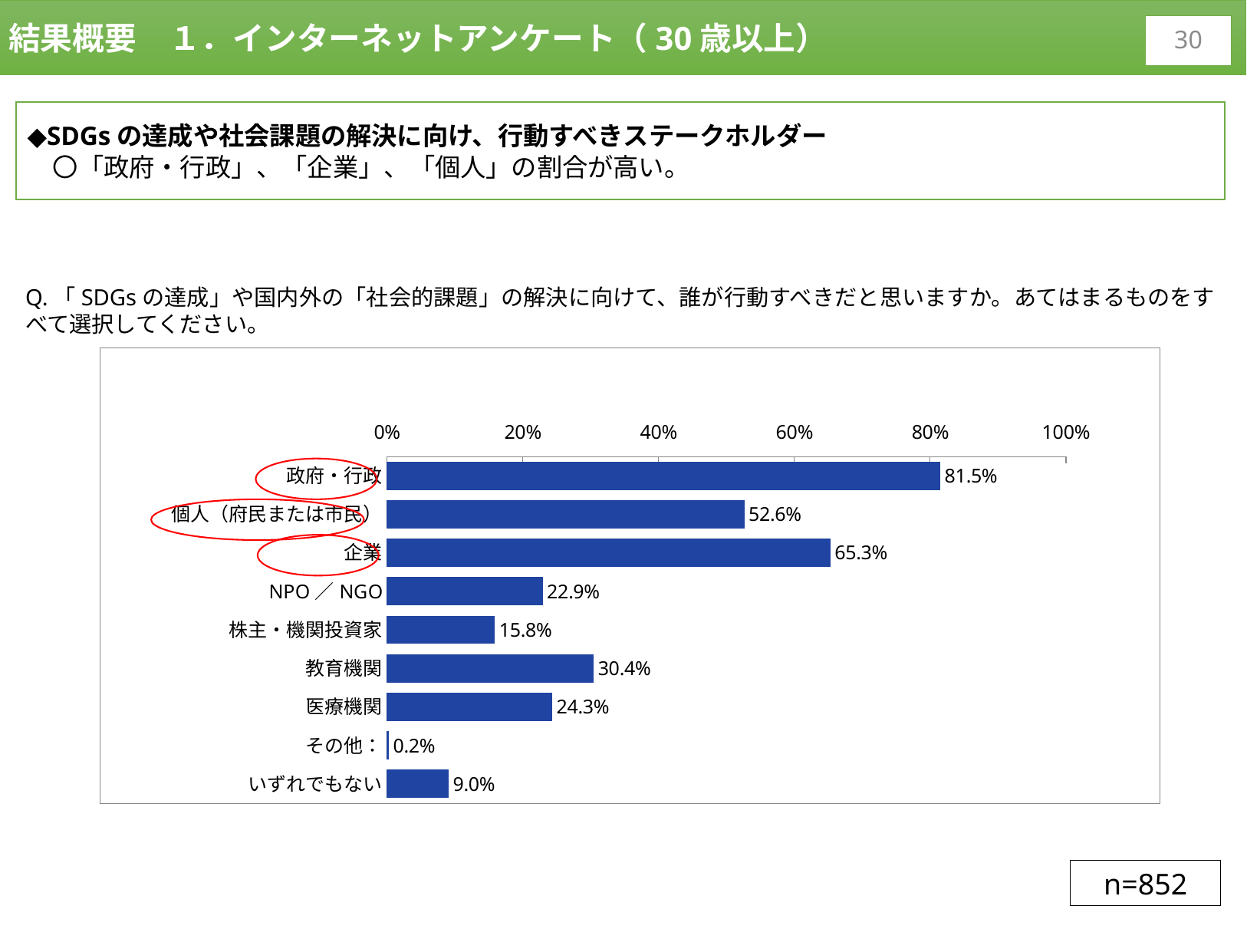
Which category has the highest value? 政府・行政 What is the sample size shown on the slide? n=852 What is the value for 企業? 65.3% How many categories are shown in the chart? 9 What is the value for 個人（府民または市民）? 52.6% What kind of chart is shown on the slide? Bar chart What is the difference between the values for 政府・行政 and 企業? 16.2% What is the value for 政府・行政? 81.5% Which category has the lowest value? その他： What is the value for その他：? 0.2% Which is larger, the value for NPO／NGO or the value for 医療機関? 医療機関 What is the value for 教育機関? 30.4%